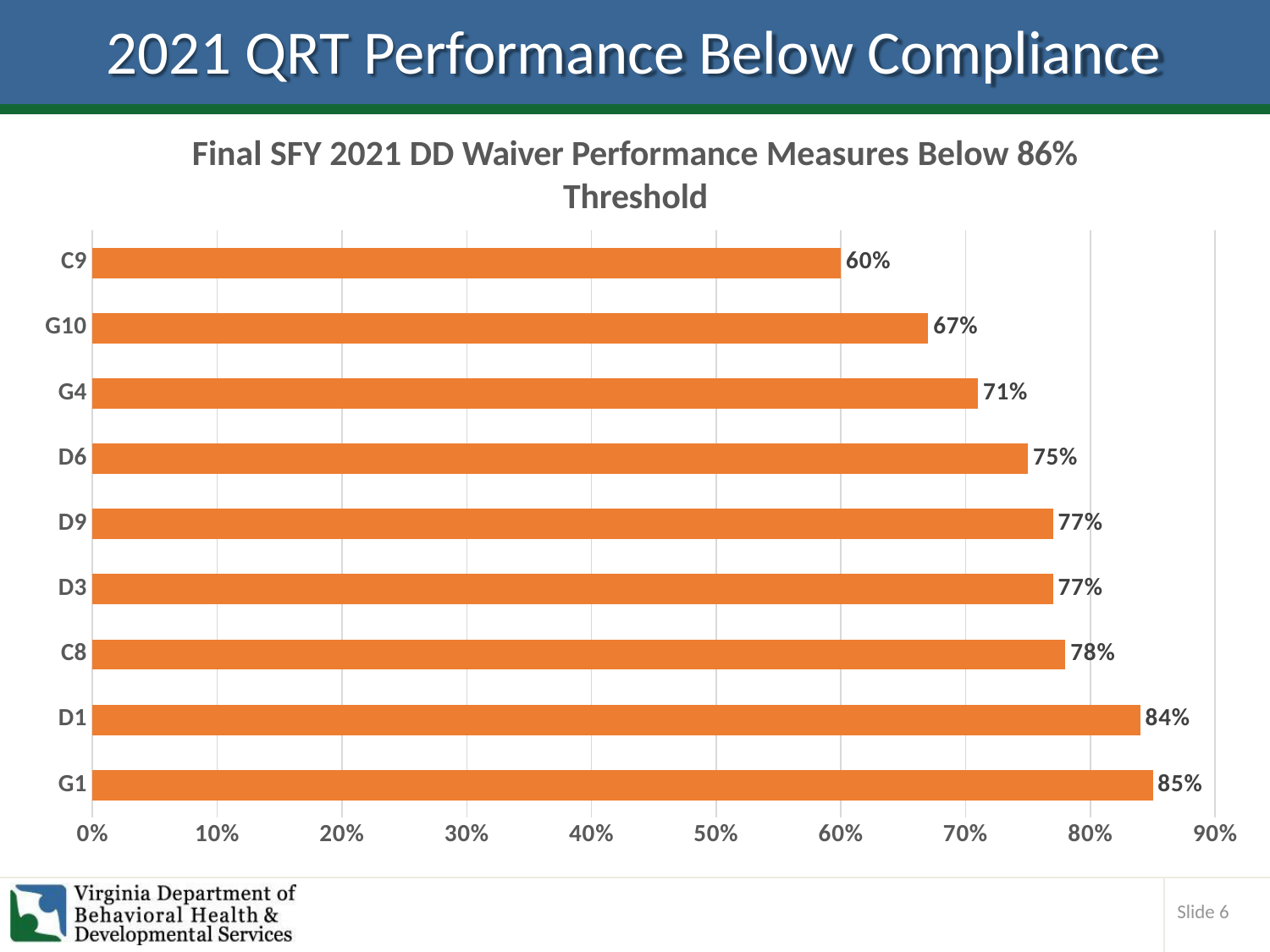
Which is larger, the value for D6 or the value for G4? D6 What is the value for G4? 71% What is the value for C8? 78% How many categories are shown in the chart? 9 Which category has the lowest value? C9 What is the difference between the values for D6 and G10? 8% Which category has the highest value? G1 Is the value for G10 greater or less than 70%? less What is the difference between the values for G1 and C9? 25% What kind of chart is shown on the slide? bar chart What is the value for D1? 84% What is the title of the chart? Final SFY 2021 DD Waiver Performance Measures Below 86% Threshold